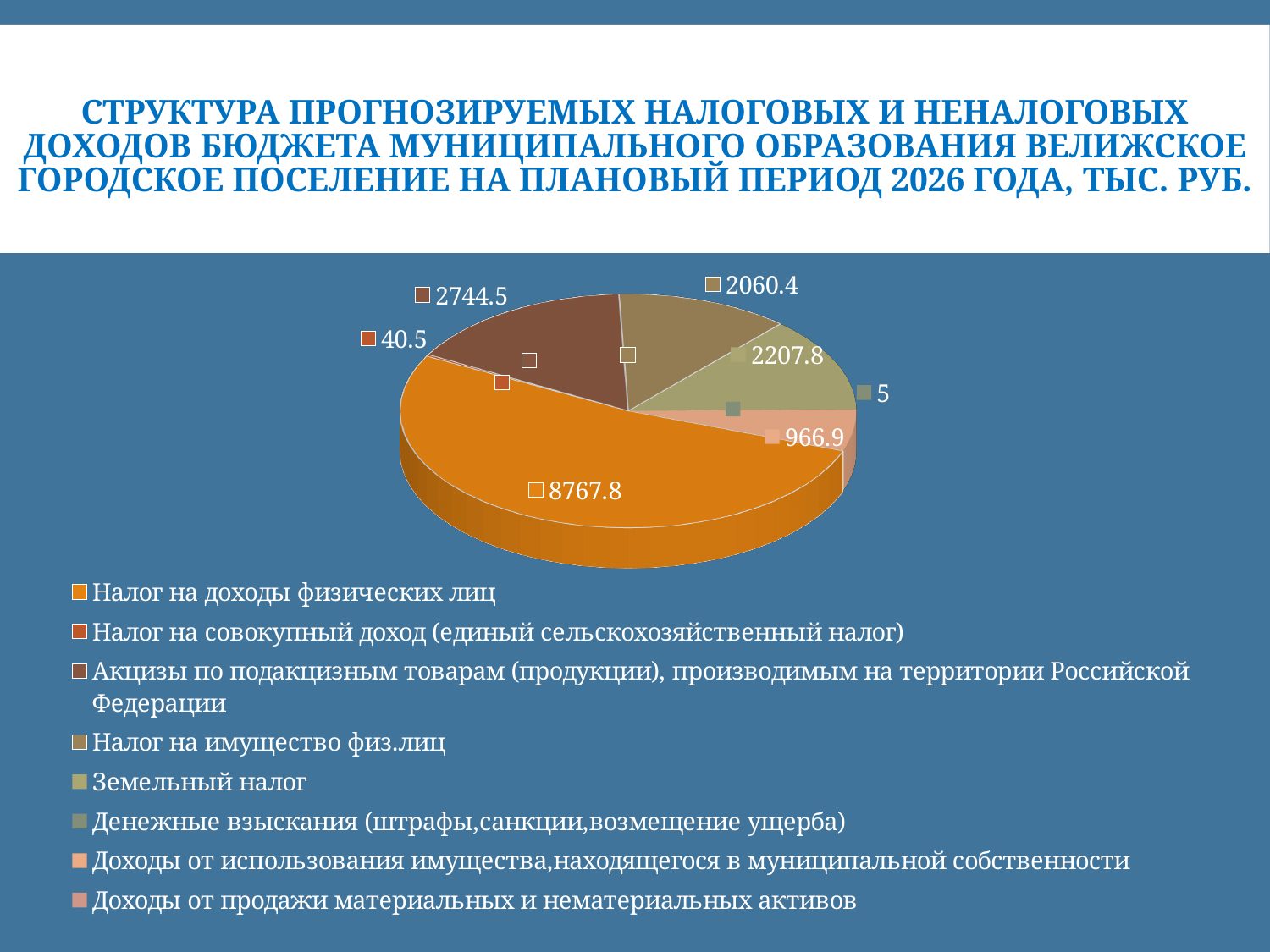
What is the difference between the value for Акцизы по подакцизным товарам and the value for Земельный налог? 536.7 How many categories does the legend of the pie chart list? 8 What kind of chart is shown on the slide? pie chart Which category has the largest slice of the pie? Налог на доходы физических лиц What is the value for Налог на доходы физических лиц? 8767.8 What is the value for Денежные взыскания (штрафы,санкции,возмещение ущерба)? 5 Which planning year does the chart title refer to? 2026 What is the value for Акцизы по подакцизным товарам (продукции), производимым на территории Российской Федерации? 2744.5 Which is larger: Земельный налог or Налог на имущество физ.лиц? Земельный налог What is the value for Земельный налог? 2207.8 What is the value for Налог на совокупный доход (единый сельскохозяйственный налог)? 40.5 What is the value for Налог на имущество физ.лиц? 2060.4